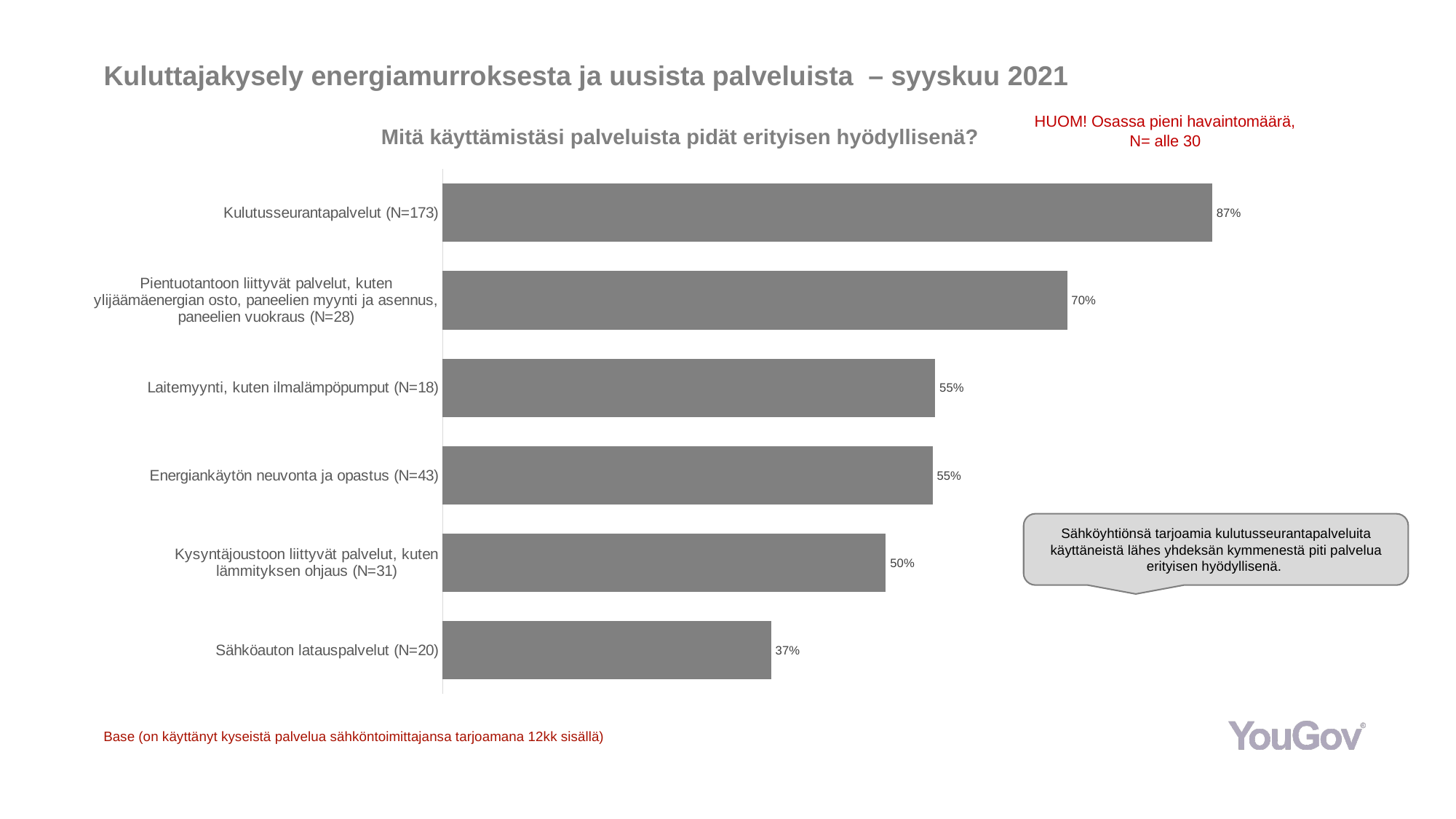
Which category has the lowest value? Sähköauton latauspalvelut (N=20) What is the value for Sähköauton latauspalvelut (N=20)? 37% Which is larger: the value for Pientuotantoon liittyvät palvelut or for Laitemyynti, kuten ilmalämpöpumput? Pientuotantoon liittyvät palvelut How many categories are shown in the chart? 6 What is the difference between the values for Kulutusseurantapalvelut and Sähköauton latauspalvelut? 50 percentage points What is the title of the chart? Mitä käyttämistäsi palveluista pidät erityisen hyödyllisenä? What value is shown for Energiankäytön neuvonta ja opastus (N=43)? 55% What is the value for Pientuotantoon liittyvät palvelut (N=28)? 70% Which category has the highest value? Kulutusseurantapalvelut (N=173) What kind of chart is shown on the slide? Bar chart What percentage is shown for Kysyntäjoustoon liittyvät palvelut, kuten lämmityksen ohjaus (N=31)? 50% What percentage is shown for Kulutusseurantapalvelut (N=173)? 87%